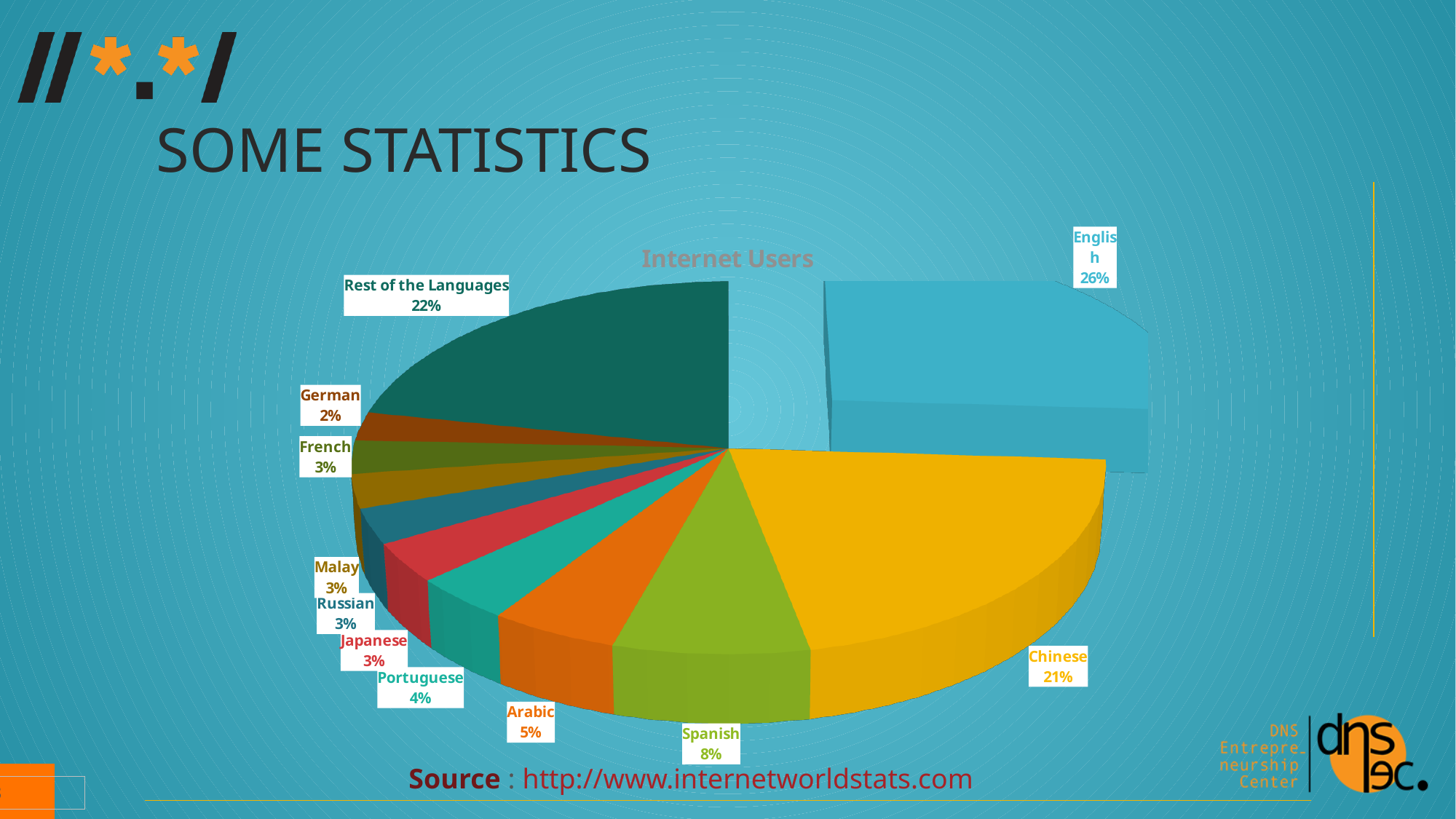
Which is larger, the share for Arabic or the share for Spanish? Spanish What percentage is shown for Portuguese? 4% Which language has the largest slice of the pie? English What is the difference in percentage points between English and Chinese? 5 What is the title of the chart? Internet Users What kind of chart is shown on the slide? Pie chart Which language has the smallest slice of the pie? German What percentage is shown for Chinese? 21% What share of Internet users does English account for? 26% What is the combined share of Japanese, Russian and Malay? 9% What percentage is shown for Spanish? 8% How many slices does the pie chart have? 11